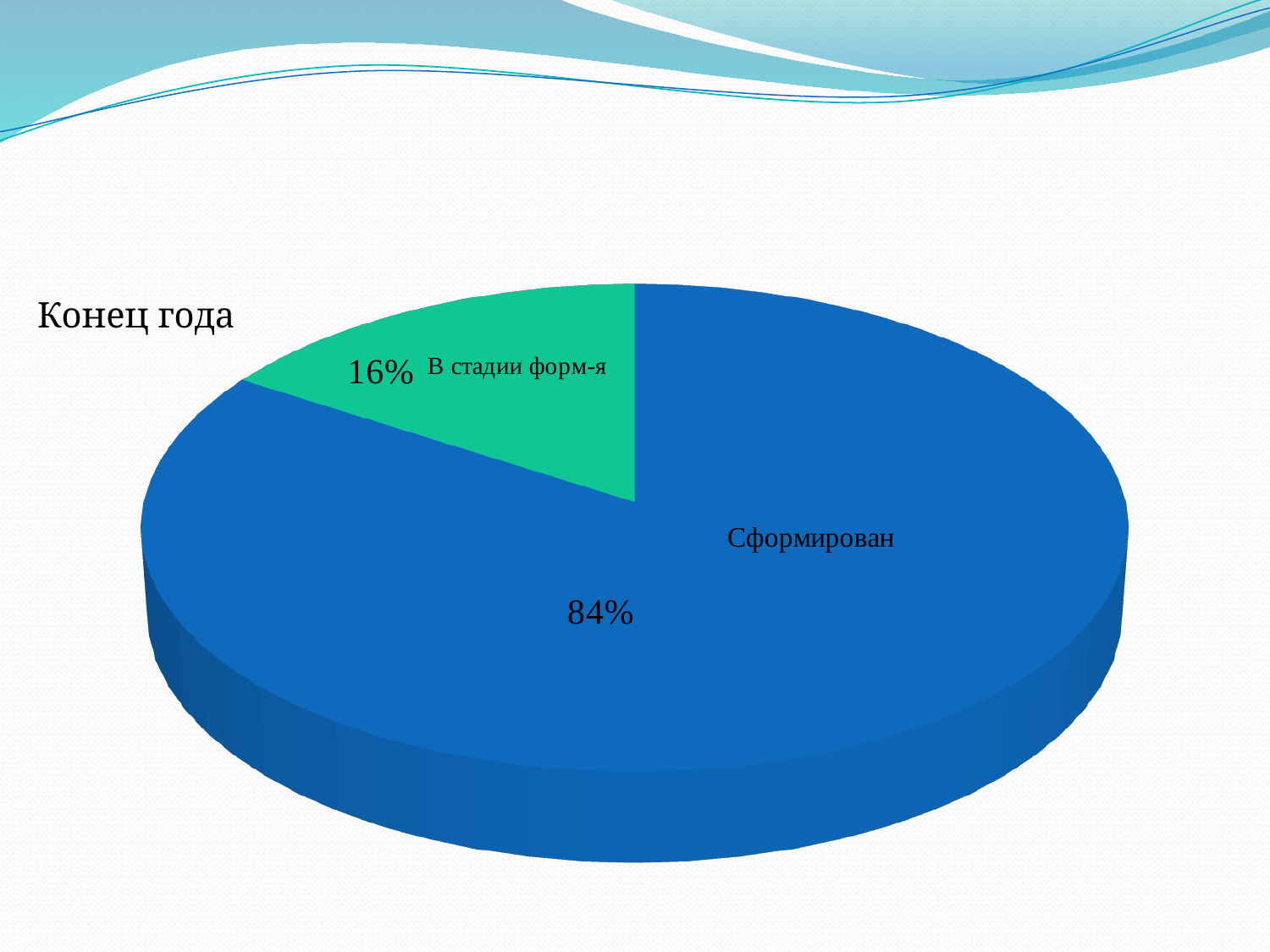
Which is larger, Сформирован or В стадии форм-я? Сформирован What kind of chart is shown on the slide? pie chart What is the value for В стадии форм-я? 16% What colour is the Сформирован slice? blue How many slices does the pie chart have? 2 Which slice is the largest? Сформирован What is the difference between the Сформирован and В стадии форм-я slices? 68% What share of the pie does В стадии форм-я take? 16% What is the value for Сформирован? 84% Which slice is the smallest? В стадии форм-я What is the title text shown next to the chart? Конец года